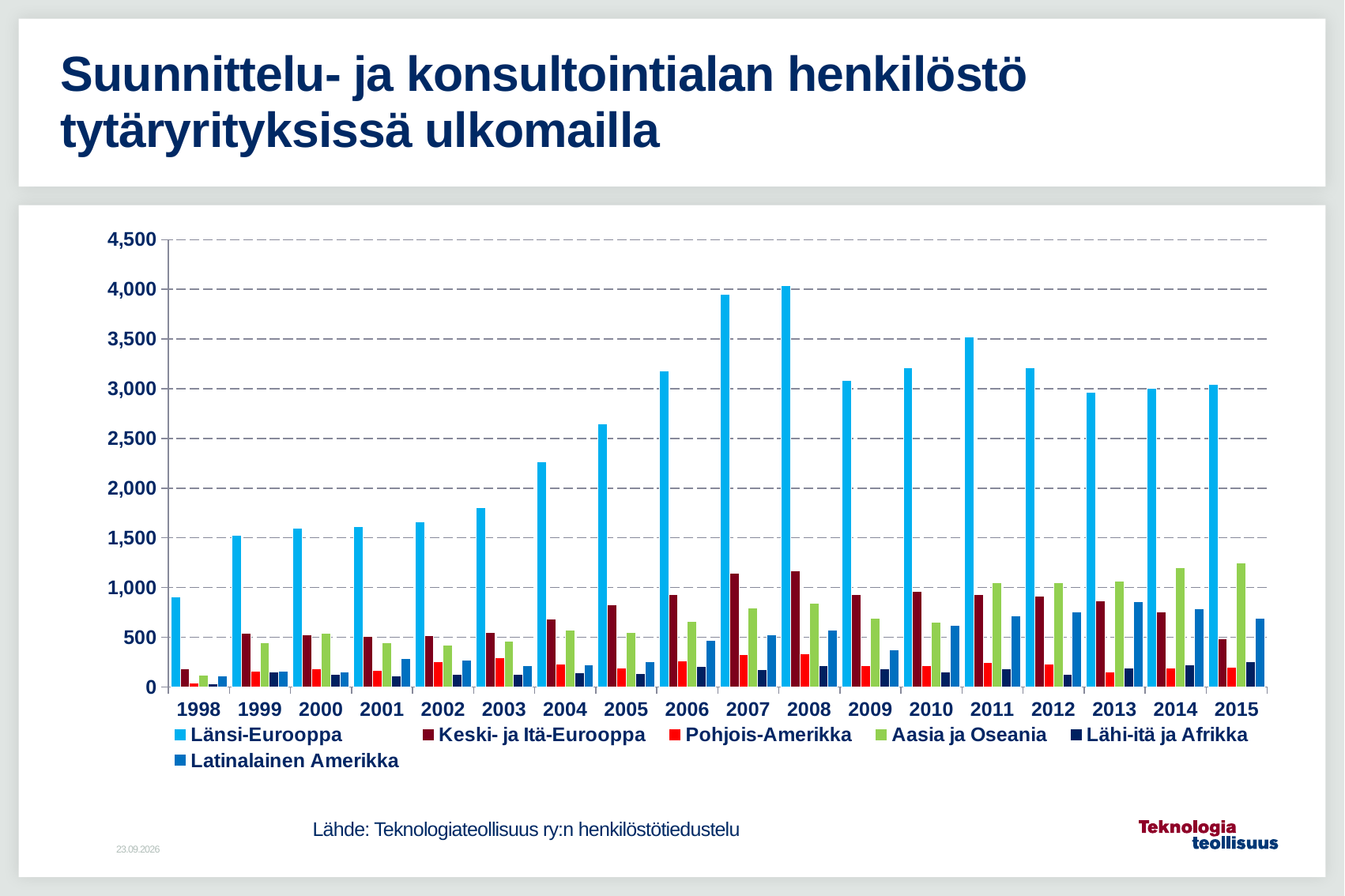
Is the value for Keski- ja Itä-Eurooppa in 2007 greater or less than 1,000? greater How many years are shown on the x axis? 18 In which year is the value for Länsi-Eurooppa lowest? 1998 Is the value for Länsi-Eurooppa in 1998 greater or less than 1,000? less Does the value for Länsi-Eurooppa rise or fall from 1998 to 2008? rise How many series does the legend list? 6 In which year is the value for Länsi-Eurooppa highest? 2008 Is the value for Länsi-Eurooppa in 2008 greater or less than 4,000? greater Which is larger, the value for Länsi-Eurooppa in 2011 or in 2013? 2011 What kind of chart is shown on the slide? Bar chart Which series is listed first in the legend? Länsi-Eurooppa